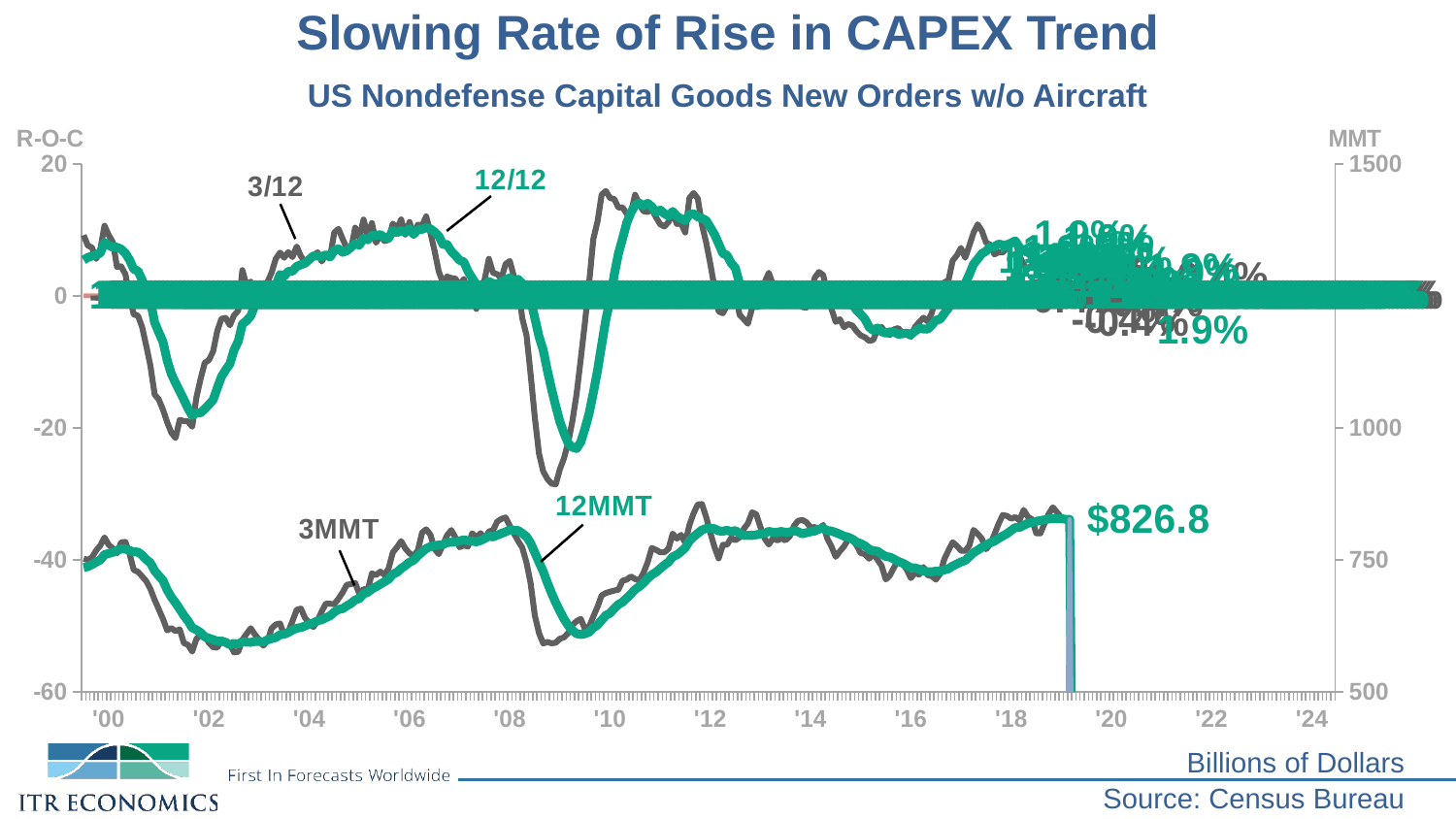
What is the title of the chart? US Nondefense Capital Goods New Orders w/o Aircraft What is the source of the data cited on the slide? Census Bureau Is the final 12MMT value greater or less than 750 on the MMT axis? greater What unit is stated for the MMT values on the slide? Billions of Dollars What is the lowest tick value shown on the left-hand R-O-C axis? -60 What is the latest value printed for the 12MMT line? $826.8 Which year labels mark the start and end of the x axis? '00 and '24 Does the 12MMT line rise or fall between 2016 and 2019? rise What is the highest tick value shown on the right-hand MMT axis? 1500 How many line series are labeled on the chart? 4 Is the lowest point of the 3/12 line, around 2009, greater or less than -20 on the R-O-C axis? less What kind of chart is shown on the slide? Line chart